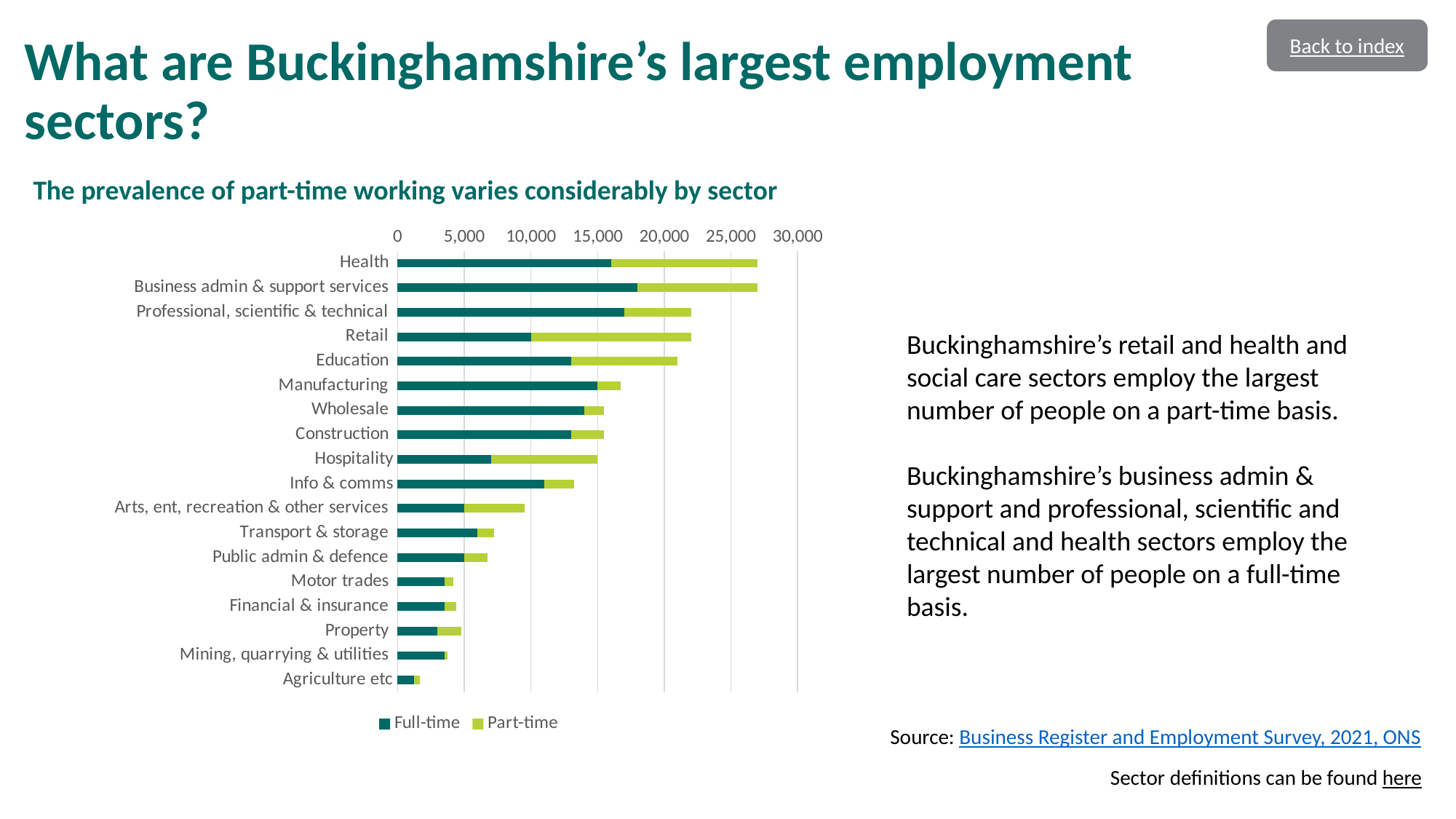
Is the total employment for Agriculture etc greater or less than 5,000? less What kind of chart is shown on the slide? Stacked bar chart Is the full-time value for Hospitality greater or less than 5,000? greater How many series does the chart legend list? 2 Which has the larger total employment: Info & comms or Arts, ent, recreation & other services? Info & comms What are the two series named in the chart legend? Full-time and Part-time Which sector has the lowest total employment on the chart? Agriculture etc Is the full-time value for Business admin & support services greater or less than 15,000? greater For Retail, which is larger: the full-time value or the part-time value? Part-time How many sectors are listed on the chart? 18